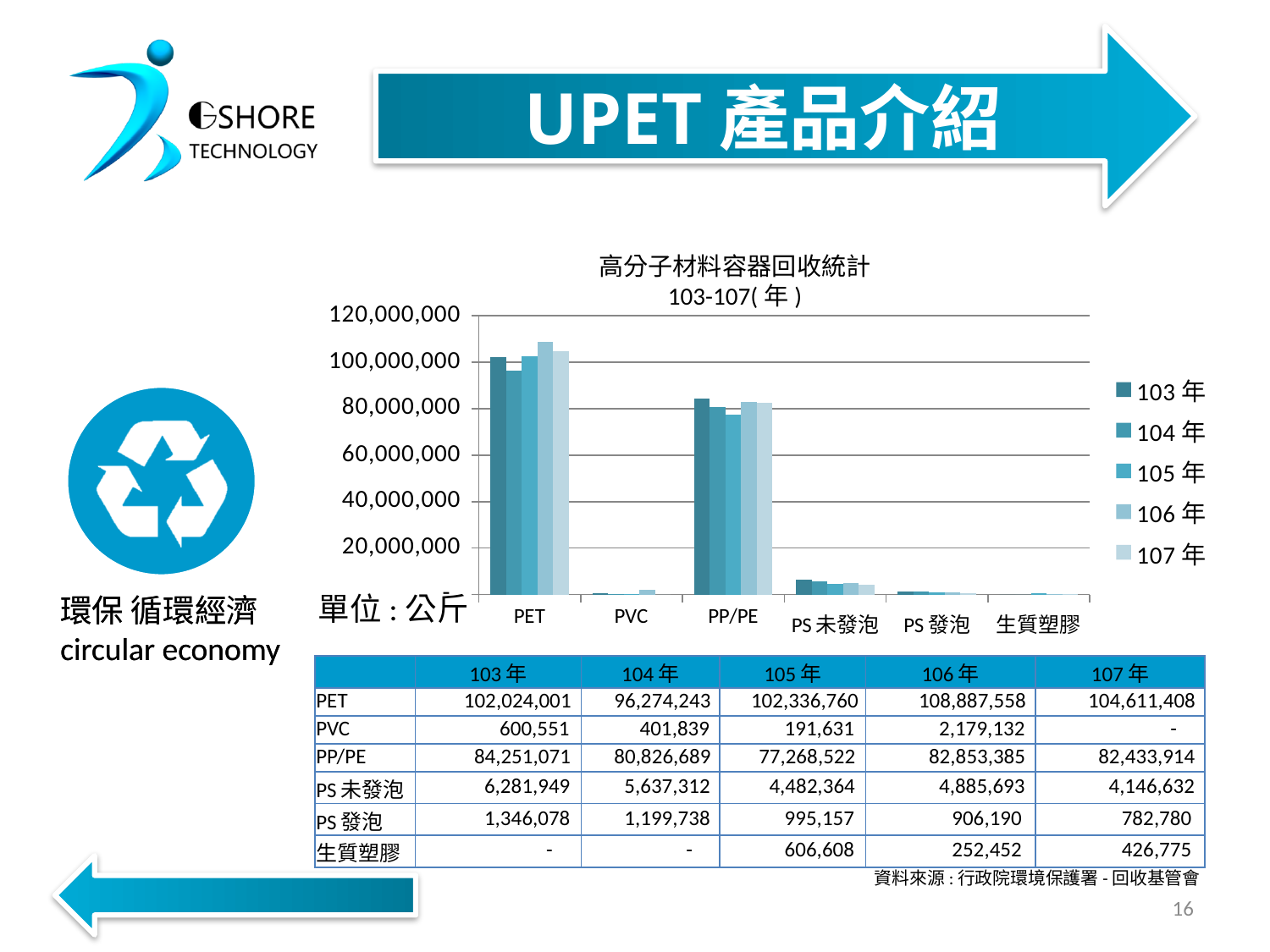
What is the value for PET in 106 年? 108,887,558 How many series does the legend of the chart list? 5 What is the value for PP/PE in 105 年? 77,268,522 Do the PS 發泡 values rise or fall from 103 年 to 107 年? fall What type of chart is shown on the slide? bar chart How many material categories are shown on the x axis of the chart? 6 Is the value for PET in 103 年 greater or less than 100,000,000? greater Which is larger, the PP/PE value for 103 年 or for 104 年? 103 年 In which year is the PET value lowest? 104 年 What is the value for PS 發泡 in 107 年? 782,780 In which year is the PET value highest? 106 年 What is the difference between the PET values for 106 年 and 103 年? 6,863,557